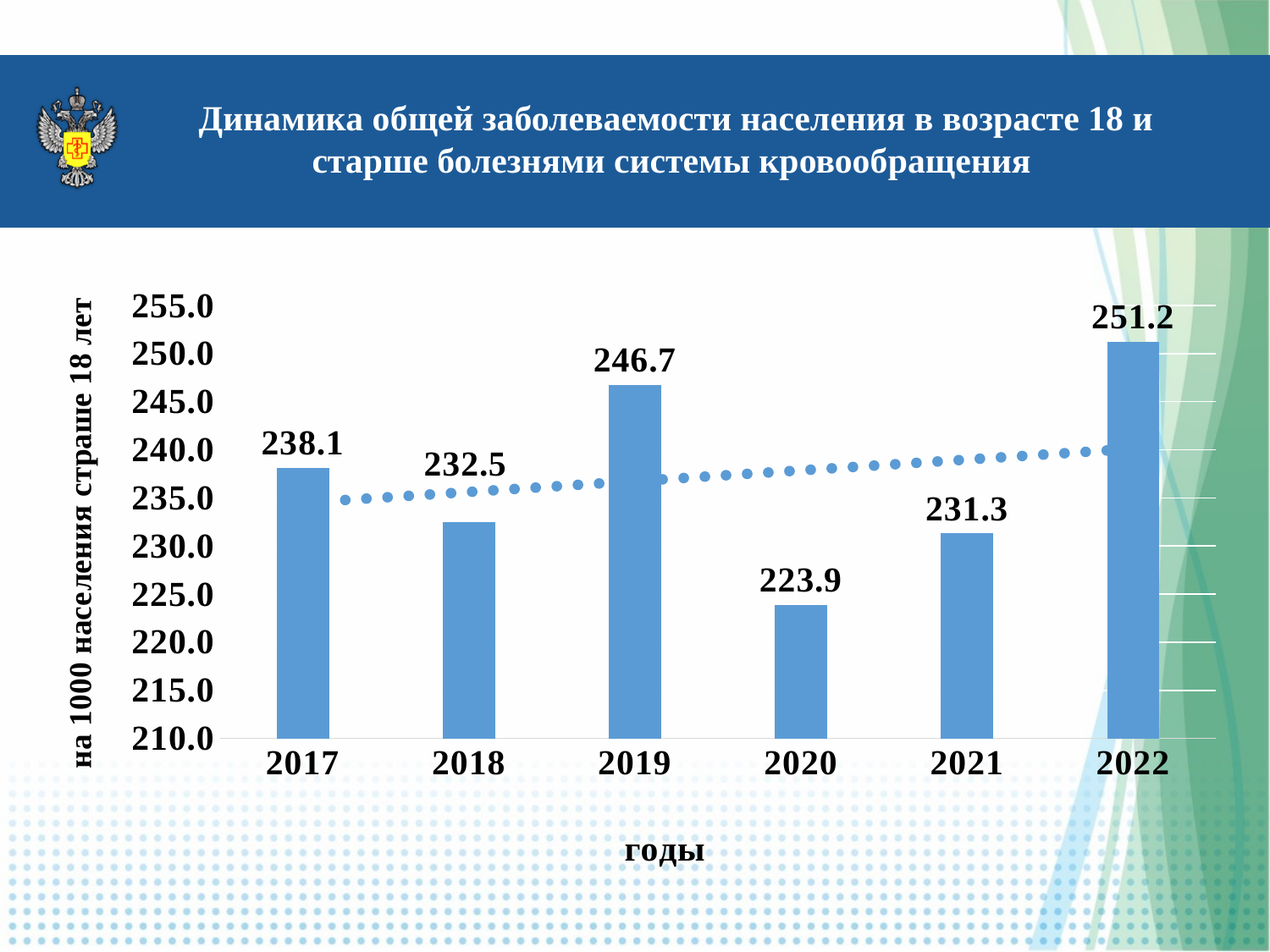
Which year has the lowest value? 2020 What kind of chart is this? bar chart What is the label of the x axis? годы What is the difference between the values for 2019 and 2018? 14.2 How many years are shown on the x axis? 6 Which is larger, the value for 2018 or the value for 2021? 2018 What is the value for 2017? 238.1 What is the value for 2022? 251.2 Is the value for 2019 greater or less than 245.0? greater What is the difference between the values for 2022 and 2020? 27.3 What is the value for 2020? 223.9 Which year has the highest value? 2022